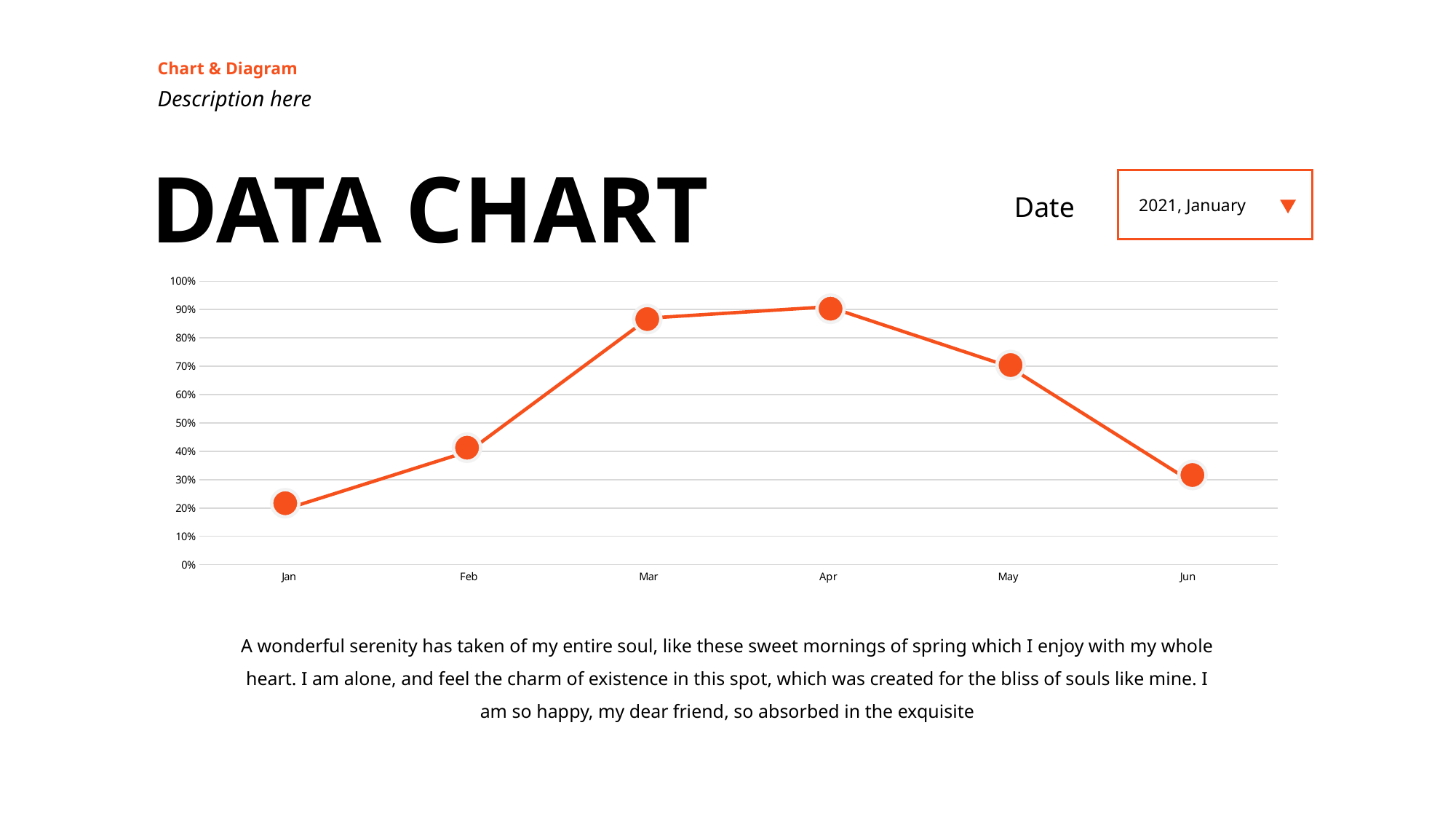
Is the value for Mar greater or less than 80%? greater What kind of chart is shown on the slide? line chart How many months are plotted on the x axis of the chart? 6 Which month has the lowest value on the chart? Jan Do the values rise or fall from Jan to Apr? rise What date is shown in the dropdown box next to the chart title? 2021, January Which month has the highest value on the chart? Apr Is the value for Jan greater or less than 30%? less Do the values rise or fall from Apr to Jun? fall Which is larger, the value for Feb or the value for May? May Is the value for Feb greater or less than 50%? less